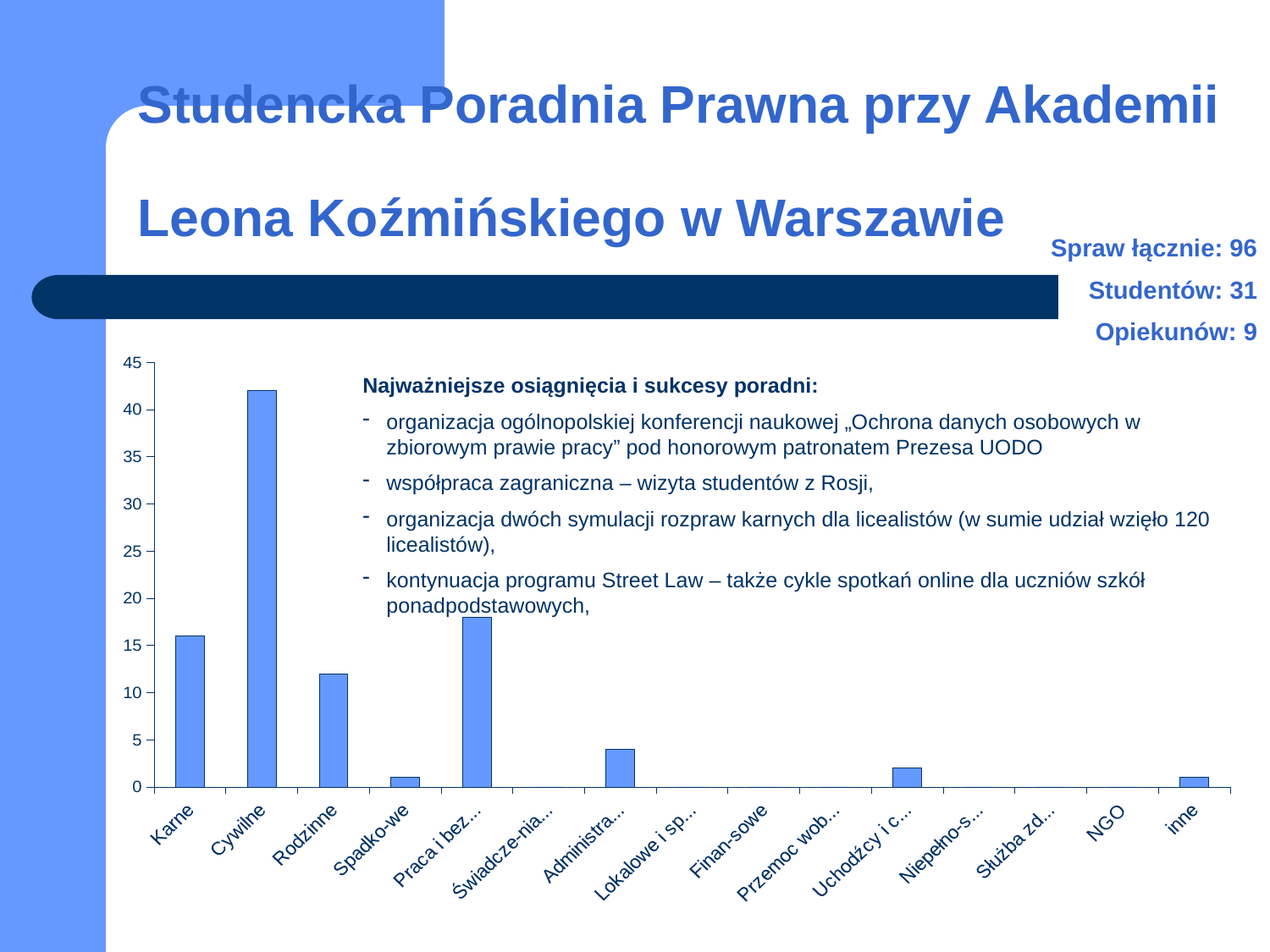
Is the value for Rodzinne greater or less than 10? greater Is the value for Uchodźcy i c... greater or less than 5? less Is the value for Karne greater or less than 15? greater What is the highest value shown on the chart's vertical axis? 45 Which category has the highest bar in the chart? Cywilne Which is larger, the value for Karne or the value for Rodzinne? Karne What kind of chart is shown on the slide? bar chart How many categories are shown on the x axis of the chart? 15 Which is larger, the value for Cywilne or the value for Praca i bez...? Cywilne